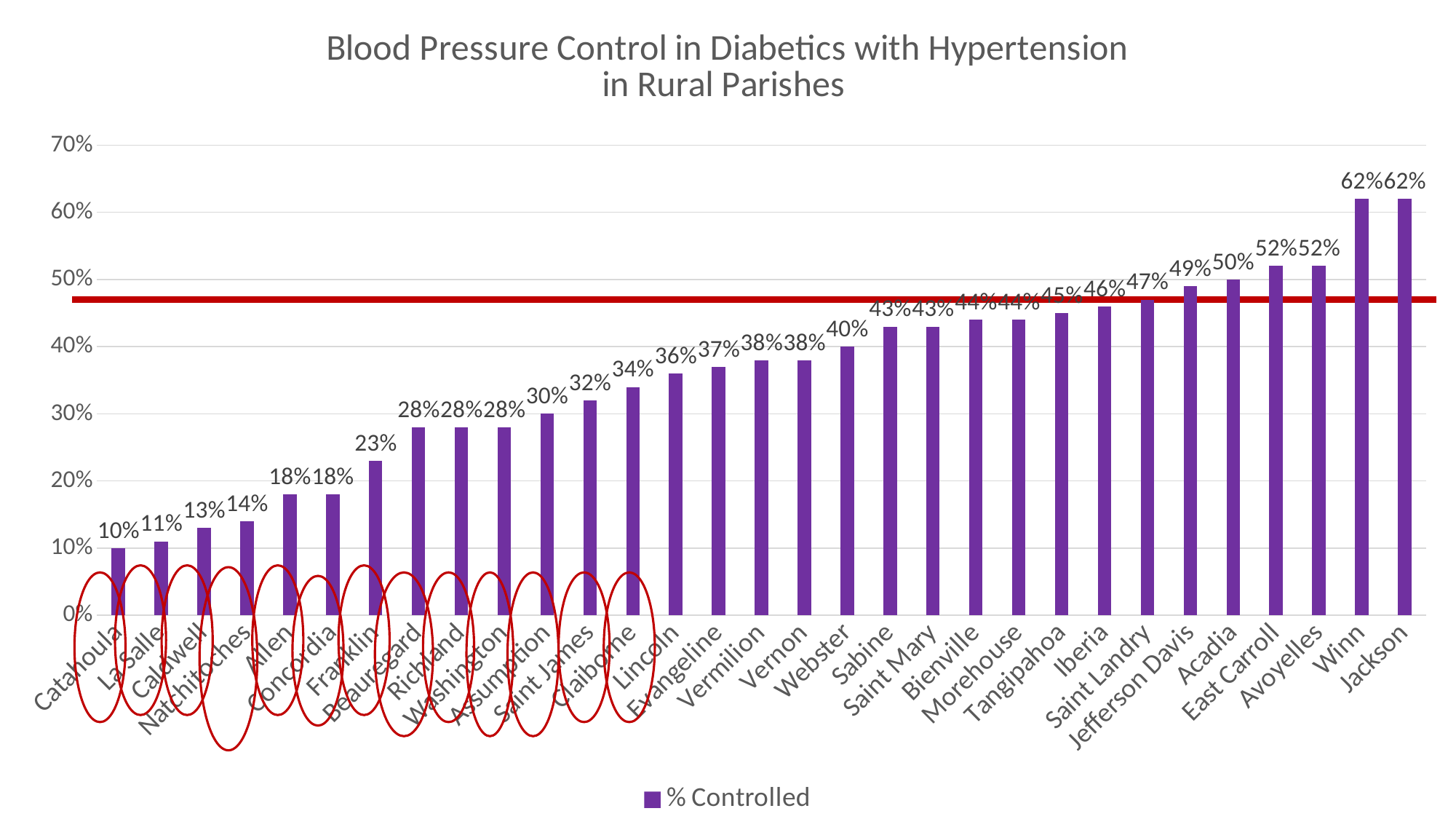
How many parishes are shown on the x axis? 31 Do the values rise or fall from left to right along the x axis? rise What is the difference in % Controlled between Winn and Lincoln? 26% How many series does the legend list? 1 What is the % Controlled value for Webster? 40% What is the % Controlled value for Franklin? 23% Which has a higher % Controlled value, Sabine or Claiborne? Sabine Is the value for Iberia greater or less than 50%? less What is the difference in % Controlled between Acadia and Catahoula? 40% Which parish has the lowest % Controlled value? Catahoula What kind of chart is shown on the slide? bar chart What is the % Controlled value for Jefferson Davis? 49%